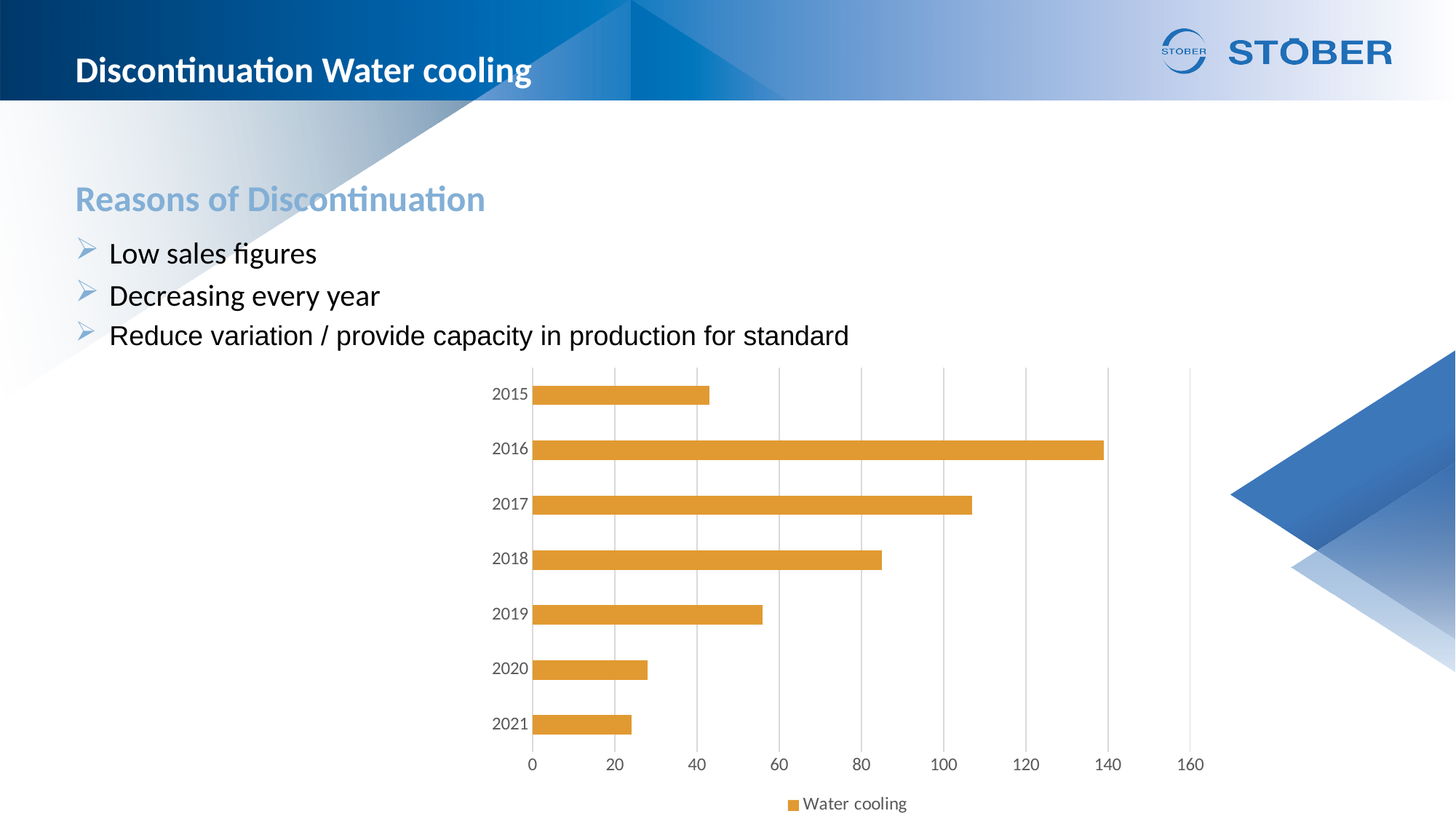
How many years are plotted on the chart? 7 From 2016 to 2021, do the values rise or fall? fall What kind of chart is shown on the slide? bar chart Which year has the lowest value for Water cooling? 2021 Which year has the highest value for Water cooling? 2016 Is the value for 2020 greater or less than 40? less How many series does the chart legend list? 1 Is the value for 2018 greater or less than 80? greater Is the value for 2015 greater or less than 60? less What is the name of the series shown in the chart legend? Water cooling Which year has the larger value, 2017 or 2019? 2017